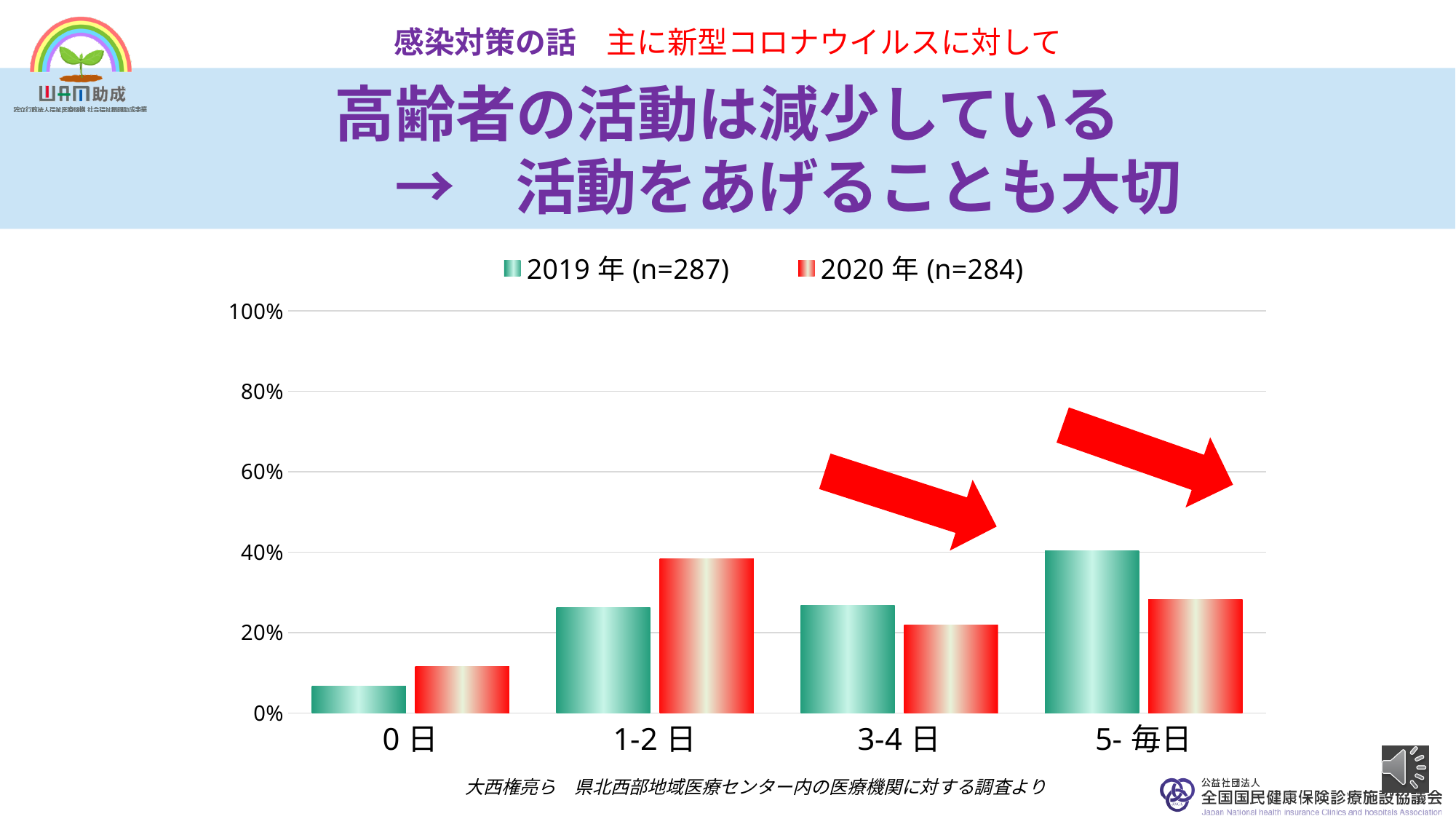
How many series does the legend list? 2 Which category has the lowest value for 2019年 (n=287)? 0 日 For the 5- 毎日 category, which series has the larger value, 2019年 or 2020年? 2019年 For the 1-2 日 category, which series has the larger value, 2019年 or 2020年? 2020年 What are the two legend entries of the chart? 2019 年 (n=287) and 2020 年 (n=284) Which category has the highest value for 2020年 (n=284)? 1-2 日 Is the value for 2019年 in the 0 日 category greater or less than 20%? less How many categories are shown on the x axis? 4 Is the value for 2020年 in the 5- 毎日 category greater or less than 20%? greater Which category has the lowest value for 2020年 (n=284)? 0 日 What kind of chart is shown on the slide? bar chart Which category has the highest value for 2019年 (n=287)? 5- 毎日